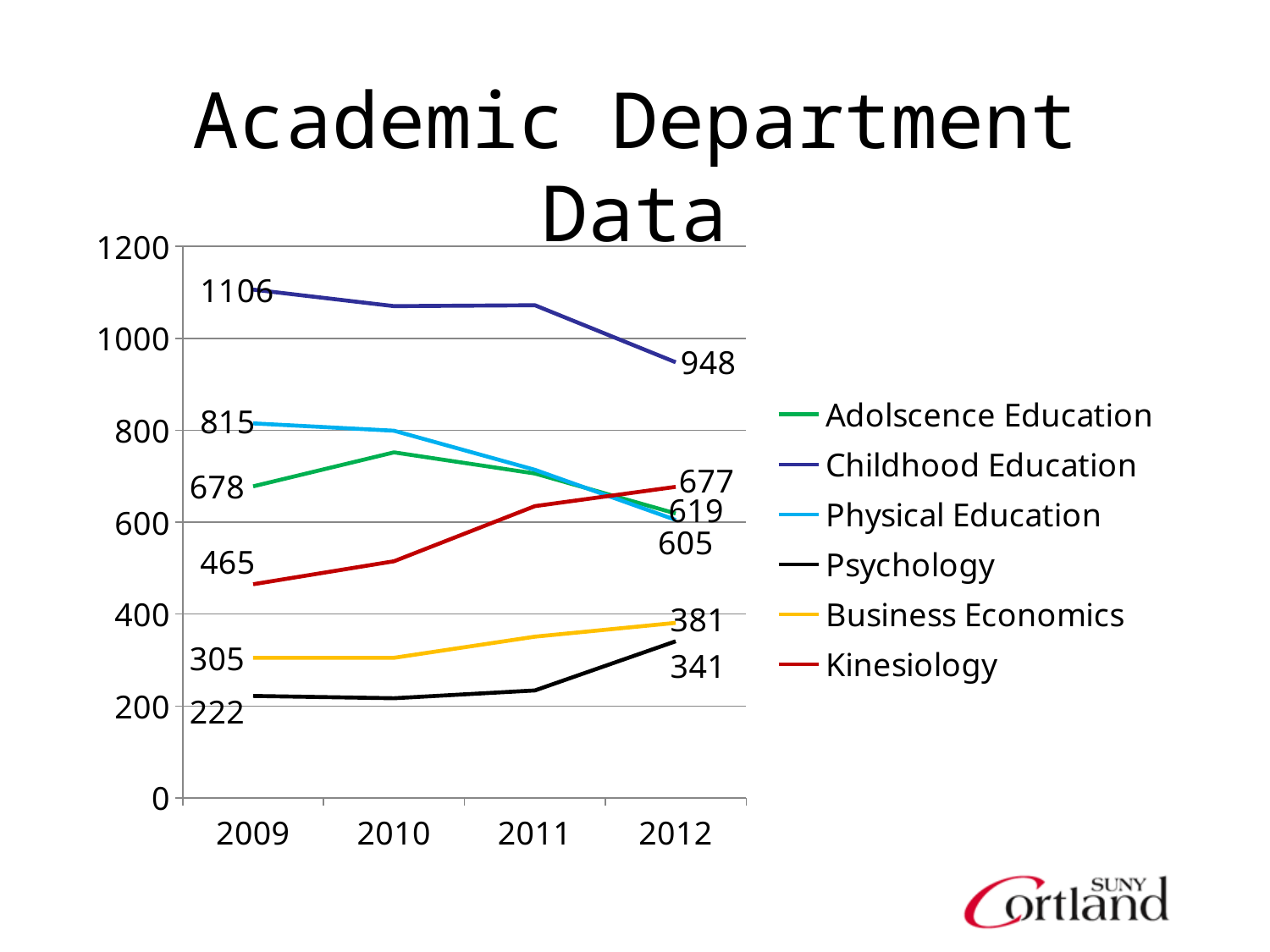
By how much did Childhood Education decrease from 2009 to 2012? 158 Which department had the highest value in 2009? Childhood Education What was the value for Kinesiology in 2009? 465 Does the Kinesiology line rise or fall from 2009 to 2012? Rises What was the value for Business Economics in 2012? 381 What kind of chart is shown on the slide? Line chart What was the value for Psychology in 2009? 222 What was the value for Childhood Education in 2009? 1106 How many series does the legend list? 6 What was the value for Kinesiology in 2012? 677 What was the value for Childhood Education in 2012? 948 Which department had the lowest value in 2009? Psychology